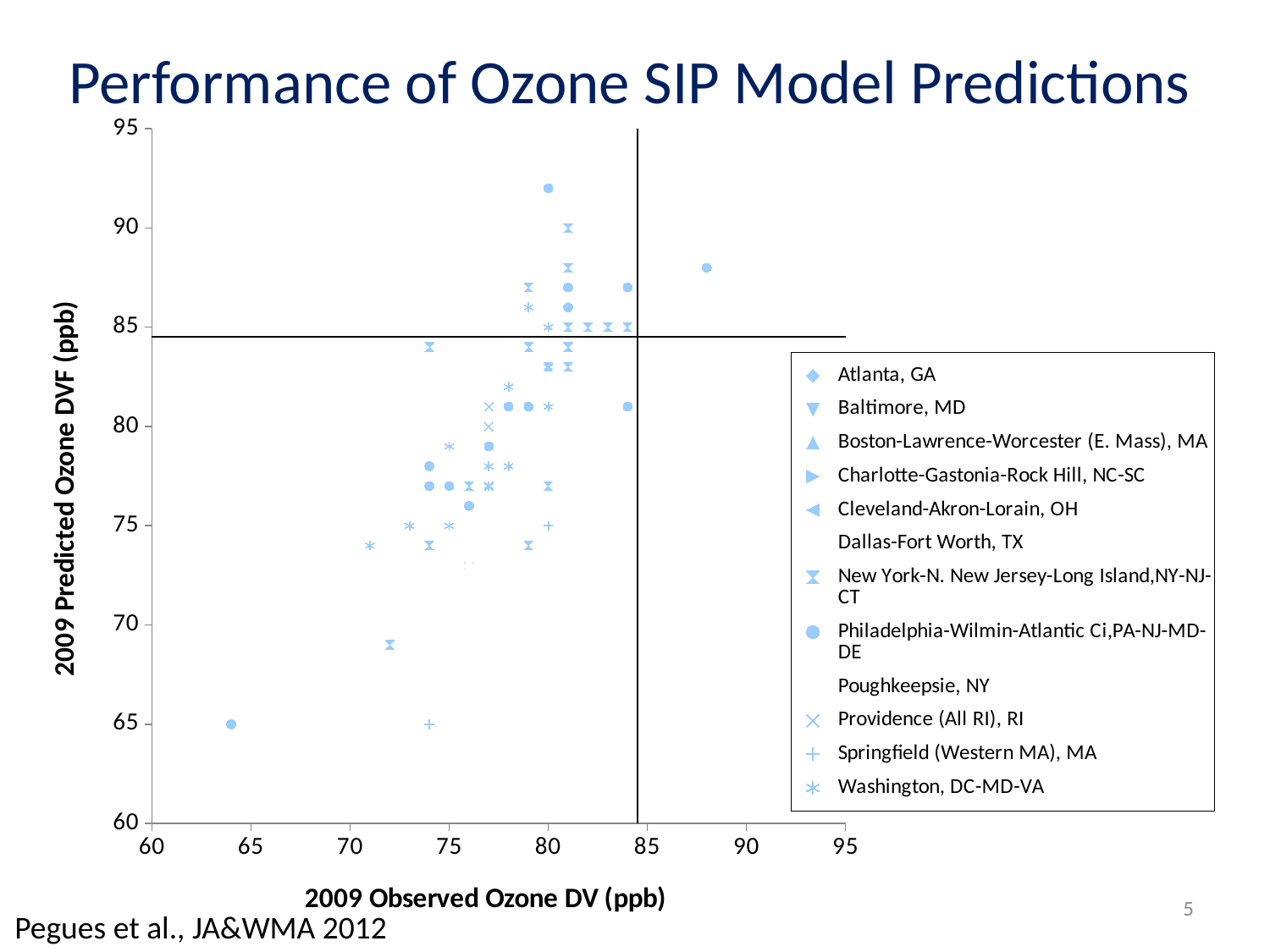
Is the predicted ozone value of the point with the highest observed ozone value greater or less than 85? greater How many series does the legend list? 12 What is the title of the chart? Performance of Ozone SIP Model Predictions What kind of chart is shown on the slide? Scatter chart Is the highest plotted observed ozone value greater or less than 85? greater Is the lowest plotted predicted ozone value greater or less than 70? less Do the predicted ozone values generally rise or fall as the observed ozone values increase along the x axis? rise What is the label of the x axis? 2009 Observed Ozone DV (ppb)